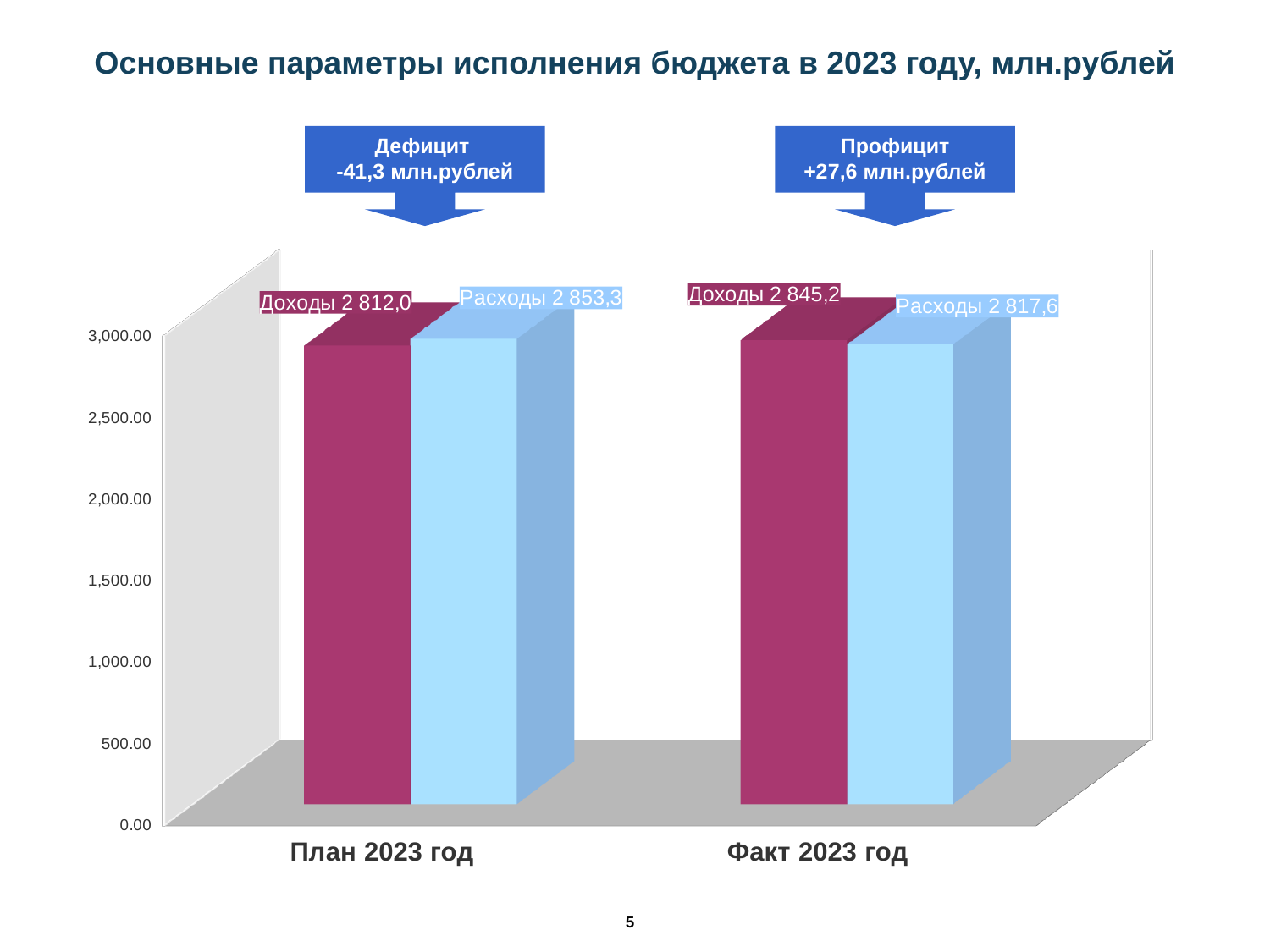
What is the value of Расходы for Факт 2023 год? 2 817,6 What is the difference between Расходы and Доходы for План 2023 год? 41,3 What is the value of Доходы for Факт 2023 год? 2 845,2 What kind of chart is shown on the slide? Bar chart Is the value of Расходы for План 2023 год greater or less than 3,000.00? less What is the value of Доходы for План 2023 год? 2 812,0 For Факт 2023 год, which is larger: Доходы or Расходы? Доходы How many categories are shown on the x axis? 2 Which bar has the highest value on the chart? Расходы, План 2023 год (2 853,3) What is the value of Расходы for План 2023 год? 2 853,3 What is the difference between Доходы and Расходы for Факт 2023 год? 27,6 Which bar has the lowest value on the chart? Доходы, План 2023 год (2 812,0)